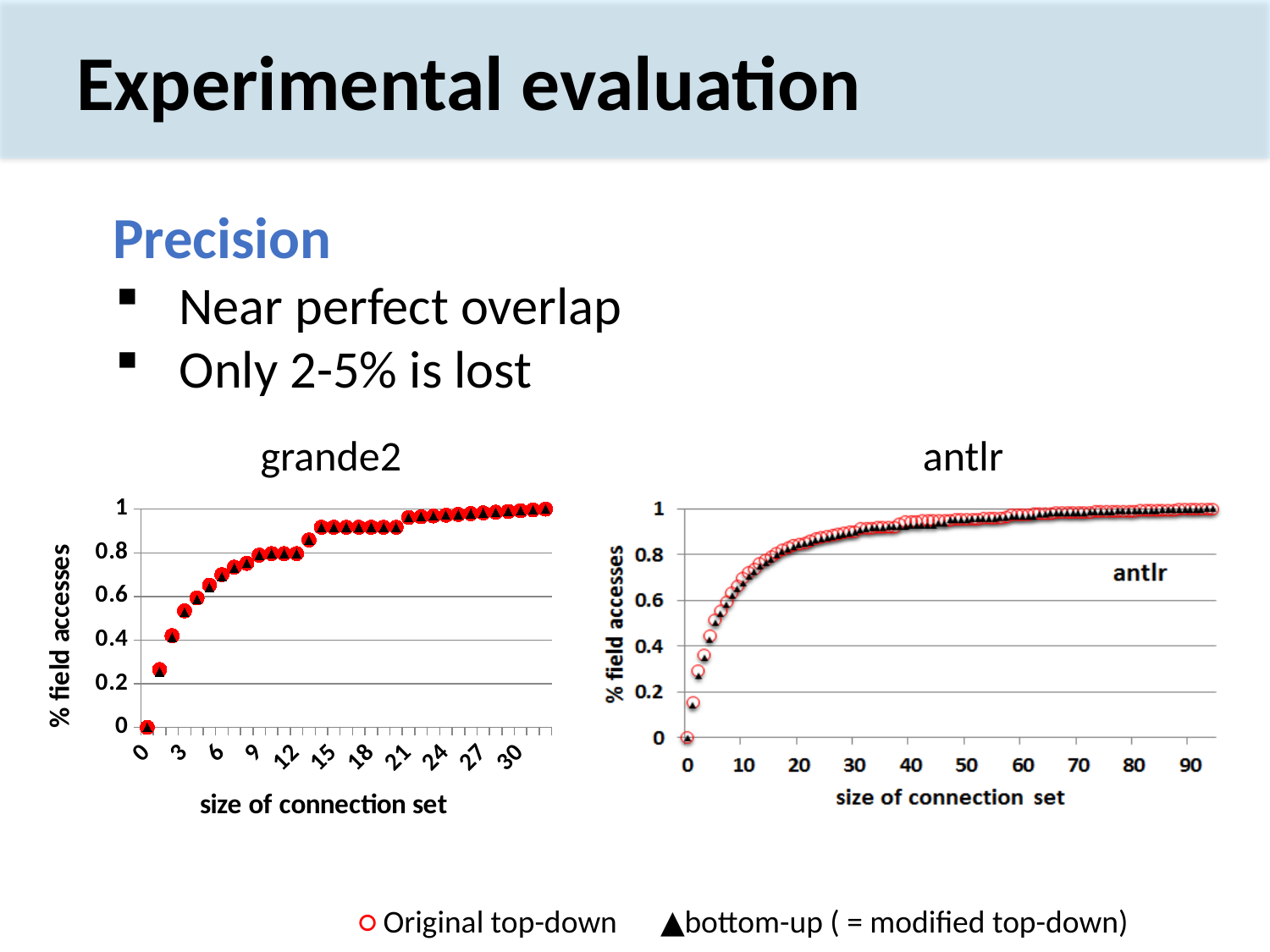
What is the label of the x axis in the antlr chart? size of connection set Which series is shown with red circle markers in the charts? Original top-down In the grande2 chart, what is the % field accesses value at a connection set size of 0? 0 In the antlr chart, is the value at a connection set size of 50 greater or less than 0.8? greater In the grande2 chart, is the value at a connection set size of 15 greater or less than 0.8? greater In the grande2 chart, do the values rise or fall as the size of connection set increases? rise In the antlr chart, is the value at a connection set size of 10 greater or less than 0.6? greater How many series does the legend at the bottom of the slide list? 2 What kind of chart is the grande2 chart? line chart In the antlr chart, do the values rise or fall as the size of connection set increases? rise